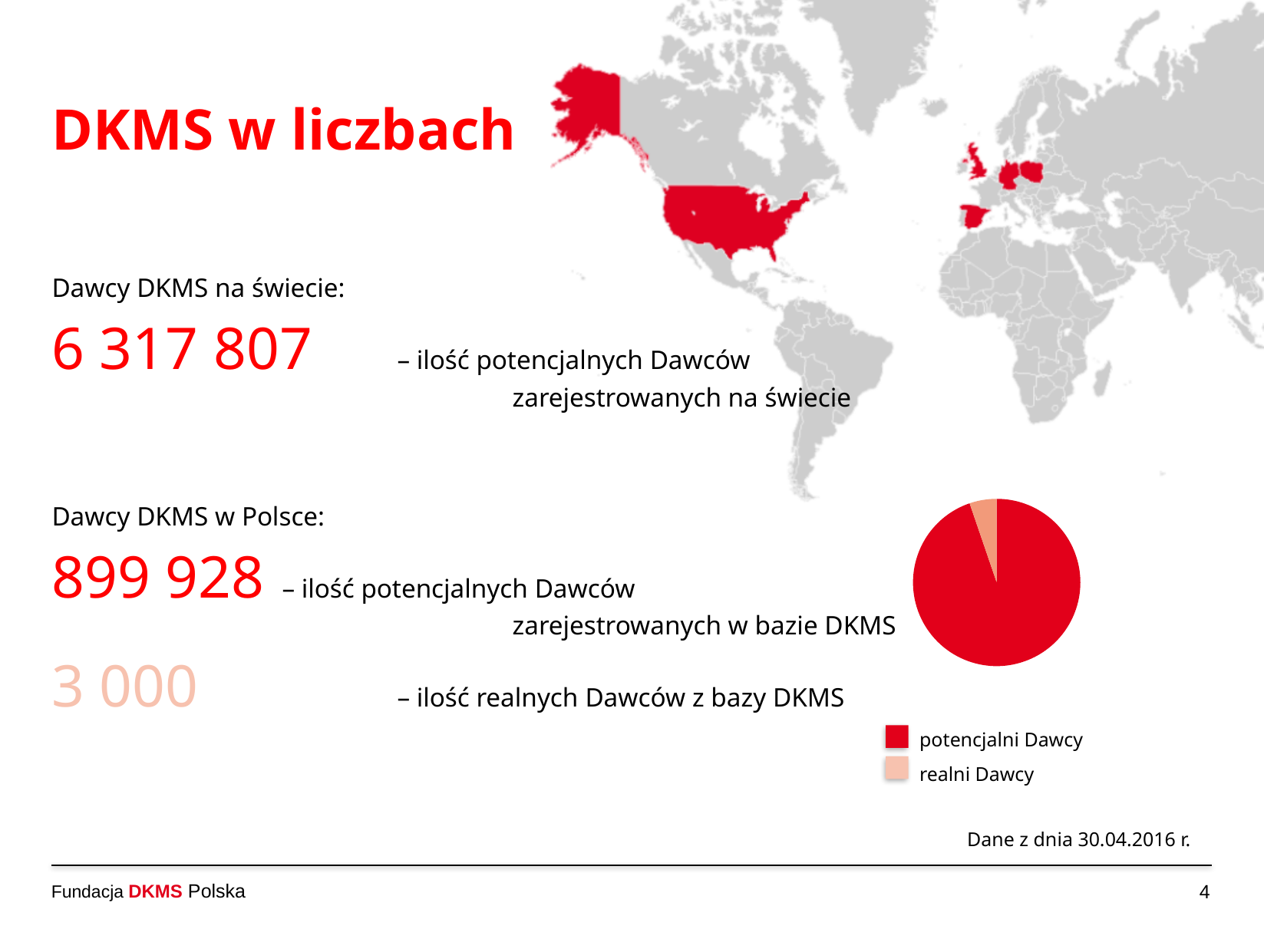
Which category takes the smallest slice of the pie chart? realni Dawcy Which category takes the largest slice of the pie chart? potencjalni Dawcy In the pie chart, which slice is larger: potencjalni Dawcy or realni Dawcy? potencjalni Dawcy What are the two legend entries of the pie chart? potencjalni Dawcy, realni Dawcy How many entries does the pie chart's legend list? 2 What colour is the slice for potencjalni Dawcy in the pie chart? red What kind of chart is shown on the slide? pie chart How many slices does the pie chart have? 2